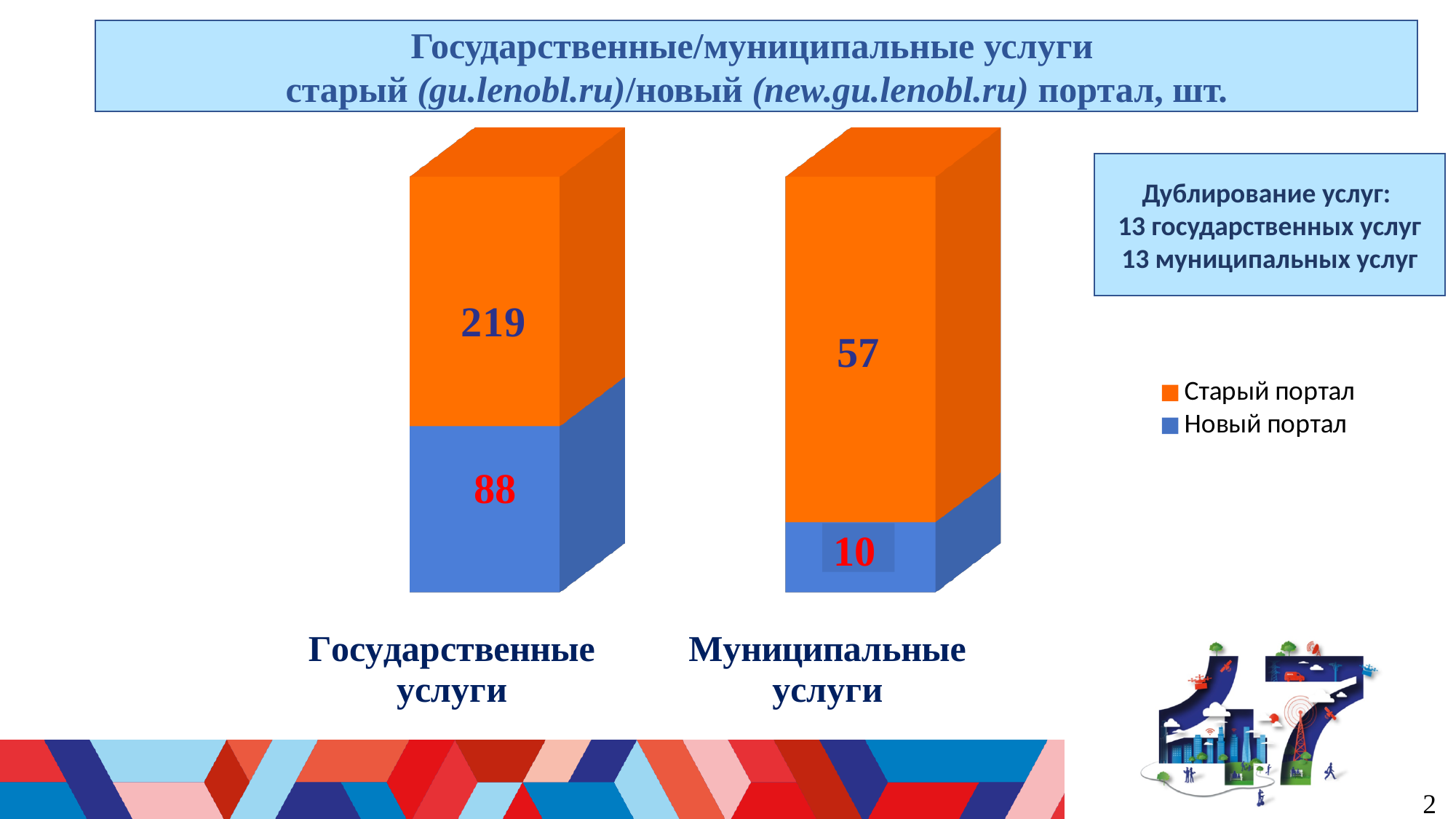
What is the value for Новый портал in the Государственные услуги bar? 88 What is the value for Старый портал in the Государственные услуги bar? 219 What is the difference between the Старый портал values for Государственные услуги and Муниципальные услуги? 162 Which is larger: the Новый портал value for Государственные услуги or the Старый портал value for Муниципальные услуги? Новый портал value for Государственные услуги How many series does the legend list? 2 What is the difference between the Старый портал and Новый портал values for Государственные услуги? 131 What kind of chart is shown on the slide? Stacked bar chart What is the value for Новый портал in the Муниципальные услуги bar? 10 What is the total of the Муниципальные услуги stacked bar? 67 Which category has the lowest value for Новый портал? Муниципальные услуги What is the value for Старый портал in the Муниципальные услуги bar? 57 Which category has the highest value for Старый портал? Государственные услуги